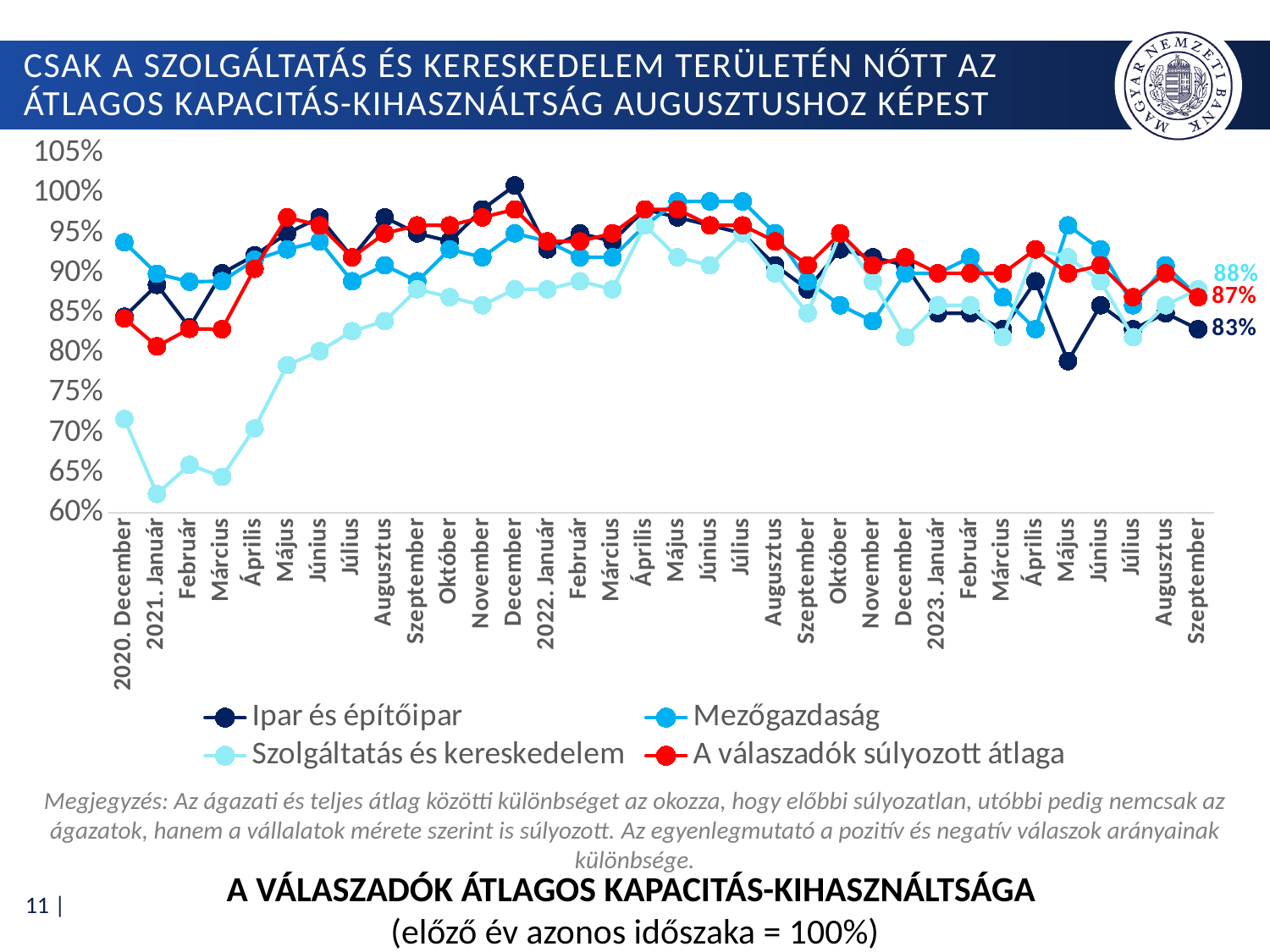
What is the value for A válaszadók súlyozott átlaga in 2023 Szeptember? 87% How many series does the legend list? 4 Does the Szolgáltatás és kereskedelem line rise or fall between 2021 Március and 2021 Augusztus? Rises Is the value for Szolgáltatás és kereskedelem in 2021 Január greater or less than 65%? less What kind of chart is shown on the slide? Line chart What is the value for Szolgáltatás és kereskedelem in 2023 Szeptember? 88% Which series is drawn in red? A válaszadók súlyozott átlaga What is the value for Ipar és építőipar in 2023 Szeptember? 83% In 2023 Szeptember, which is larger: Szolgáltatás és kereskedelem or Ipar és építőipar? Szolgáltatás és kereskedelem Is the value for Ipar és építőipar in 2021 December greater or less than 95%? greater What is the difference between Szolgáltatás és kereskedelem and Ipar és építőipar in 2023 Szeptember? 5 percentage points Which series has the lowest value in 2020 December? Szolgáltatás és kereskedelem